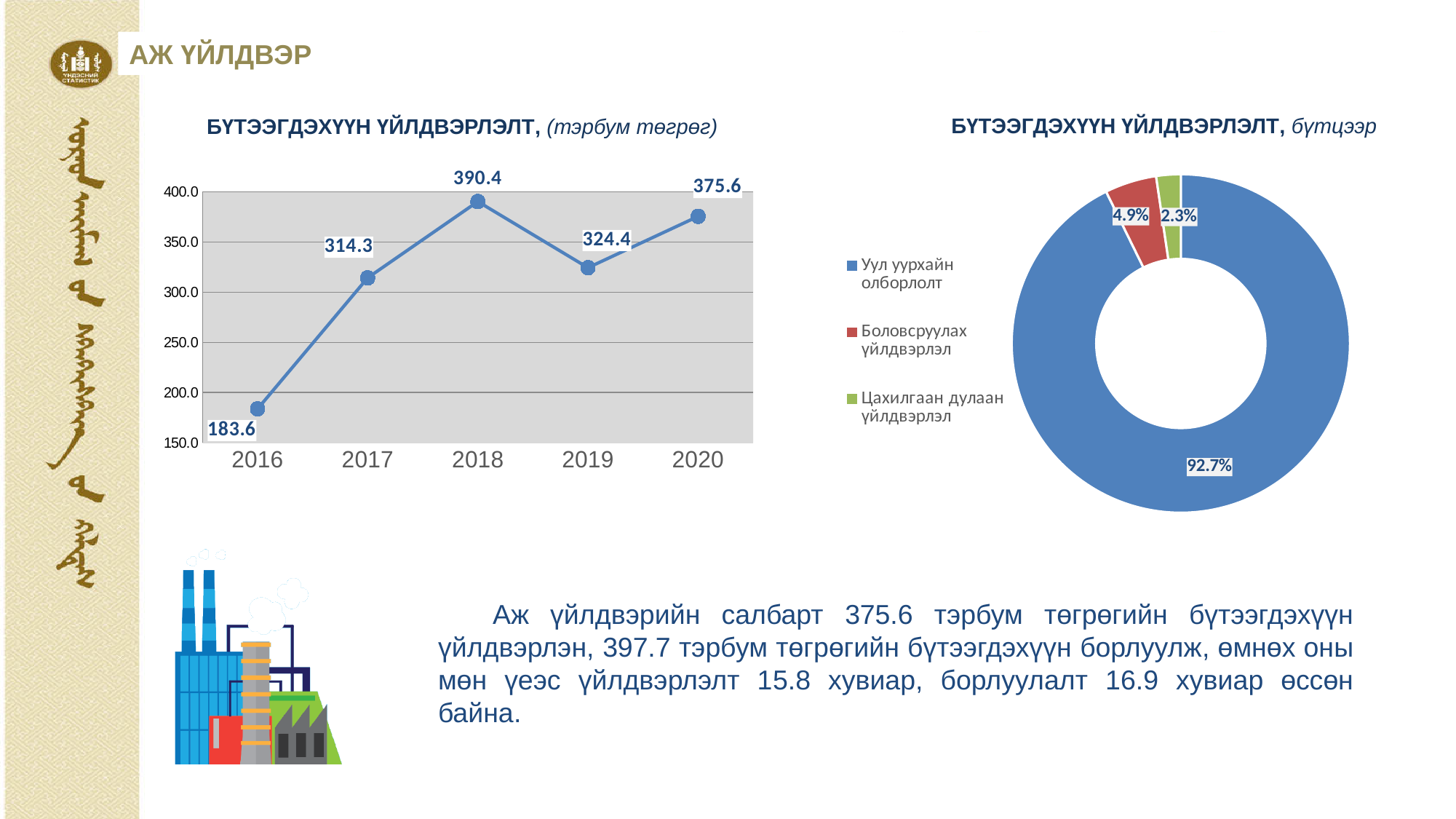
In the doughnut chart on the right (БҮТЭЭГДЭХҮҮН ҮЙЛДВЭРЛЭЛТ, бүтцээр), what share does Уул уурхайн олборлолт have? 92.7% In the line chart on the left, which year has the highest value? 2018 How many series does the legend of the doughnut chart on the right list? 3 In the line chart on the left, does the value rise or fall from 2018 to 2019? fall What type of chart is the chart on the left? line chart In the doughnut chart on the right, what share does Боловсруулах үйлдвэрлэл have? 4.9% In the line chart on the left (БҮТЭЭГДЭХҮҮН ҮЙЛДВЭРЛЭЛТ, тэрбум төгрөг), what is the value for 2018? 390.4 In the line chart on the left, what is the value for 2016? 183.6 In the line chart on the left, which year has the lowest value? 2016 In the line chart on the left, what is the difference between the 2020 value and the 2019 value? 51.2 In the line chart on the left, how many years are plotted? 5 In the line chart on the left, which is larger, the value for 2017 or the value for 2019? 2019